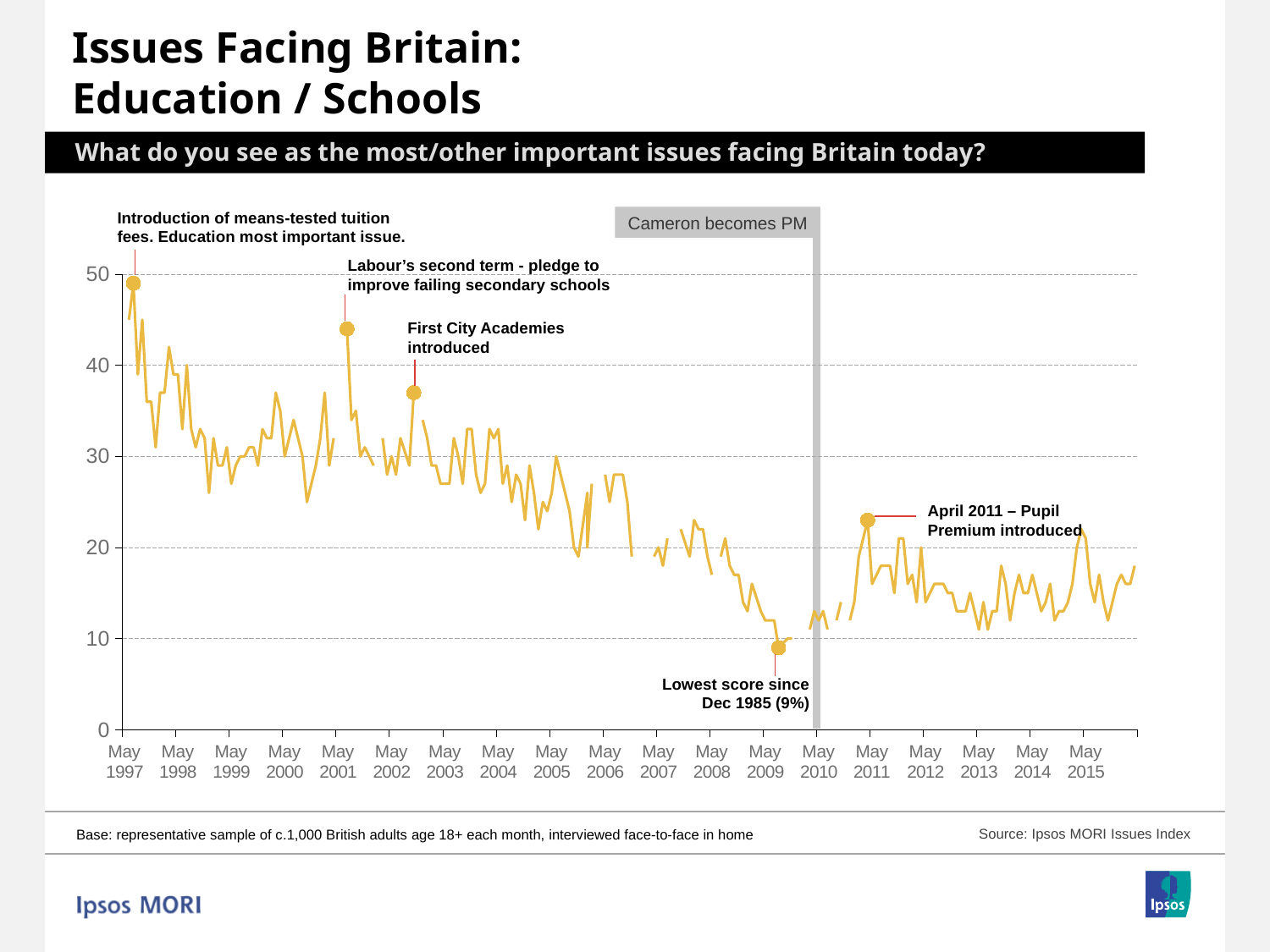
What kind of chart is shown on the slide? Line chart What event does the grey vertical band on the chart mark? Cameron becomes PM How many year labels are shown along the x axis? 19 At which x-axis label does the line reach its highest value? May 1997 Is the value at the point marked 'First City Academies introduced' greater or less than 30? greater What is the lowest score shown on the chart, as printed in the annotation? 9% What event is annotated at April 2011 on the chart? Pupil Premium introduced Is the value at May 1997 greater or less than 40? greater Overall, do the values rise or fall between May 1997 and May 2009? Fall Which is larger, the value at May 1997 or the value at May 2015? May 1997 Is the value at the point marked 'Labour's second term' greater or less than 40? greater